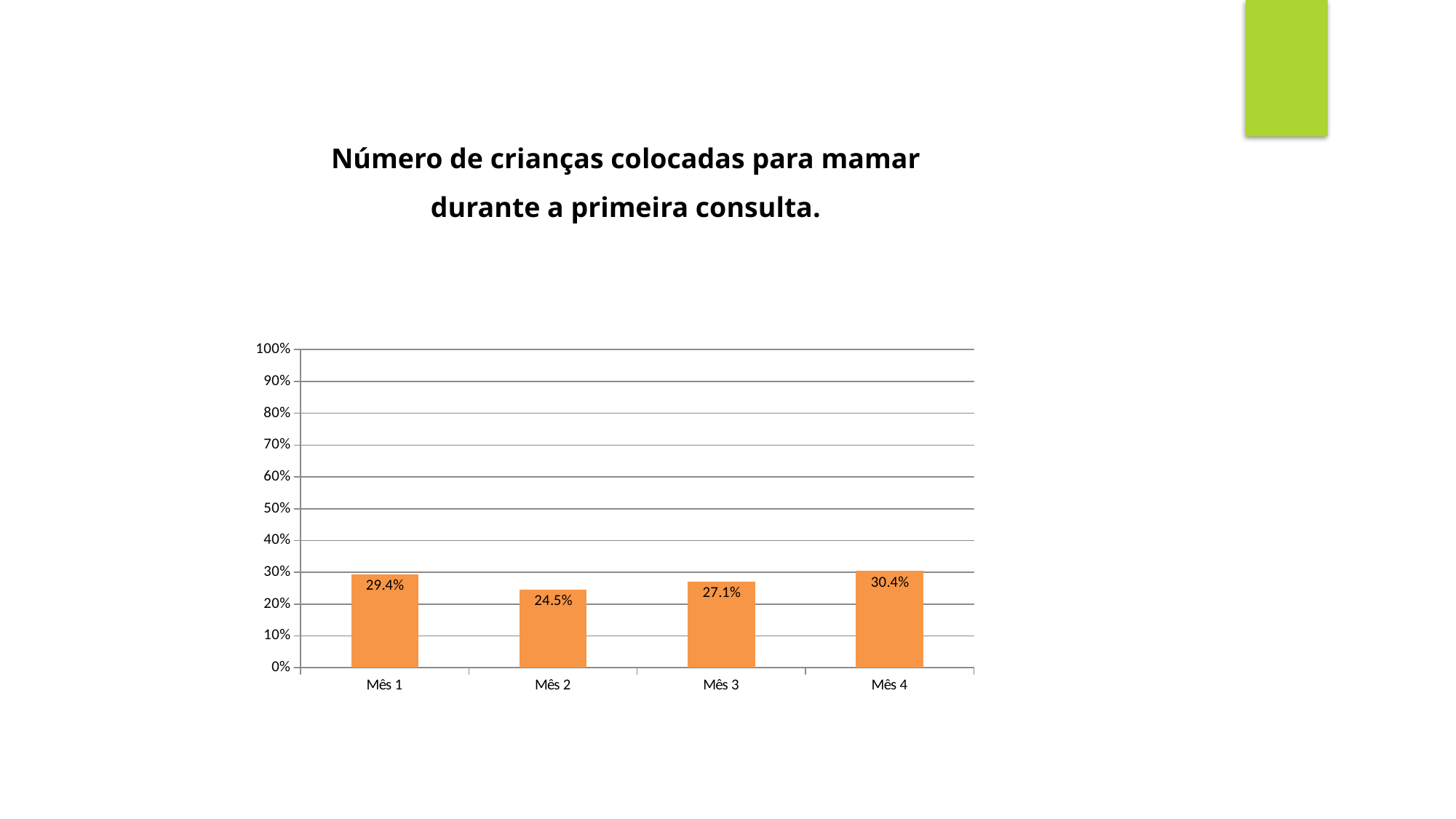
What is the value for Mês 3? 27.1% What is the value for Mês 2? 24.5% Which is larger, the value for Mês 1 or the value for Mês 3? Mês 1 What kind of chart is shown on the slide? bar chart Which month has the highest value? Mês 4 What is the title of the chart? Número de crianças colocadas para mamar durante a primeira consulta. What is the value for Mês 1? 29.4% Is the value for Mês 4 greater or less than 20%? greater What is the difference between the values for Mês 4 and Mês 2? 5.9% How many categories are shown on the x axis? 4 What is the value for Mês 4? 30.4% Which month has the lowest value? Mês 2